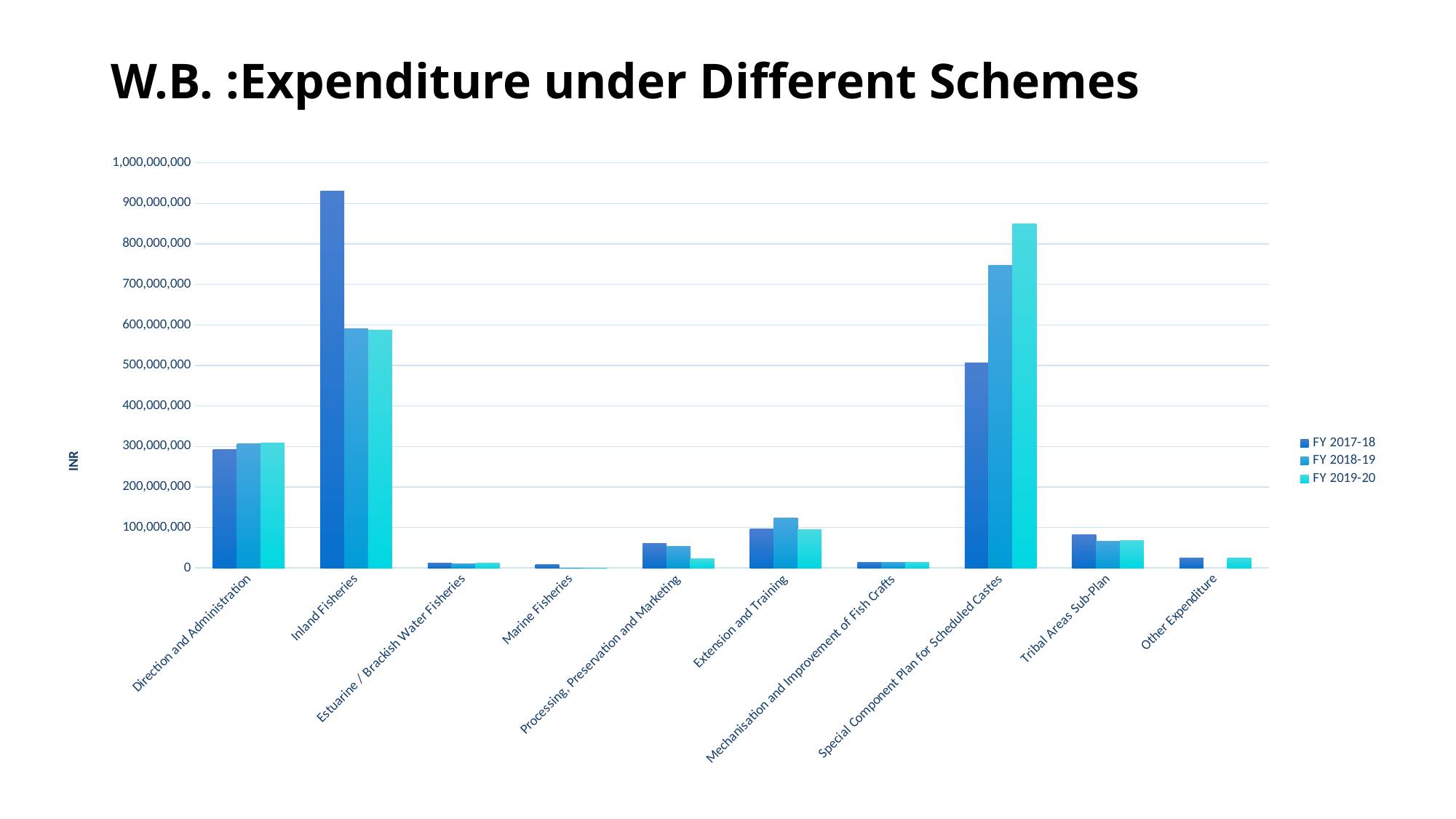
How many scheme categories are shown on the x axis? 10 Do the values for Special Component Plan for Scheduled Castes rise or fall from FY 2017-18 to FY 2019-20? Rise Is the FY 2018-19 value for Special Component Plan for Scheduled Castes greater or less than 700,000,000? greater How many series does the legend list? 3 Is the FY 2017-18 value for Inland Fisheries greater or less than 900,000,000? greater Is the FY 2017-18 value for Direction and Administration greater or less than 400,000,000? less What is the label on the y axis? INR What kind of chart is shown on the slide? Bar chart Which is larger: the FY 2017-18 value for Inland Fisheries or the FY 2019-20 value for Special Component Plan for Scheduled Castes? FY 2017-18 value for Inland Fisheries Which scheme has the tallest bar for FY 2017-18? Inland Fisheries Which scheme has the tallest bar for FY 2019-20? Special Component Plan for Scheduled Castes